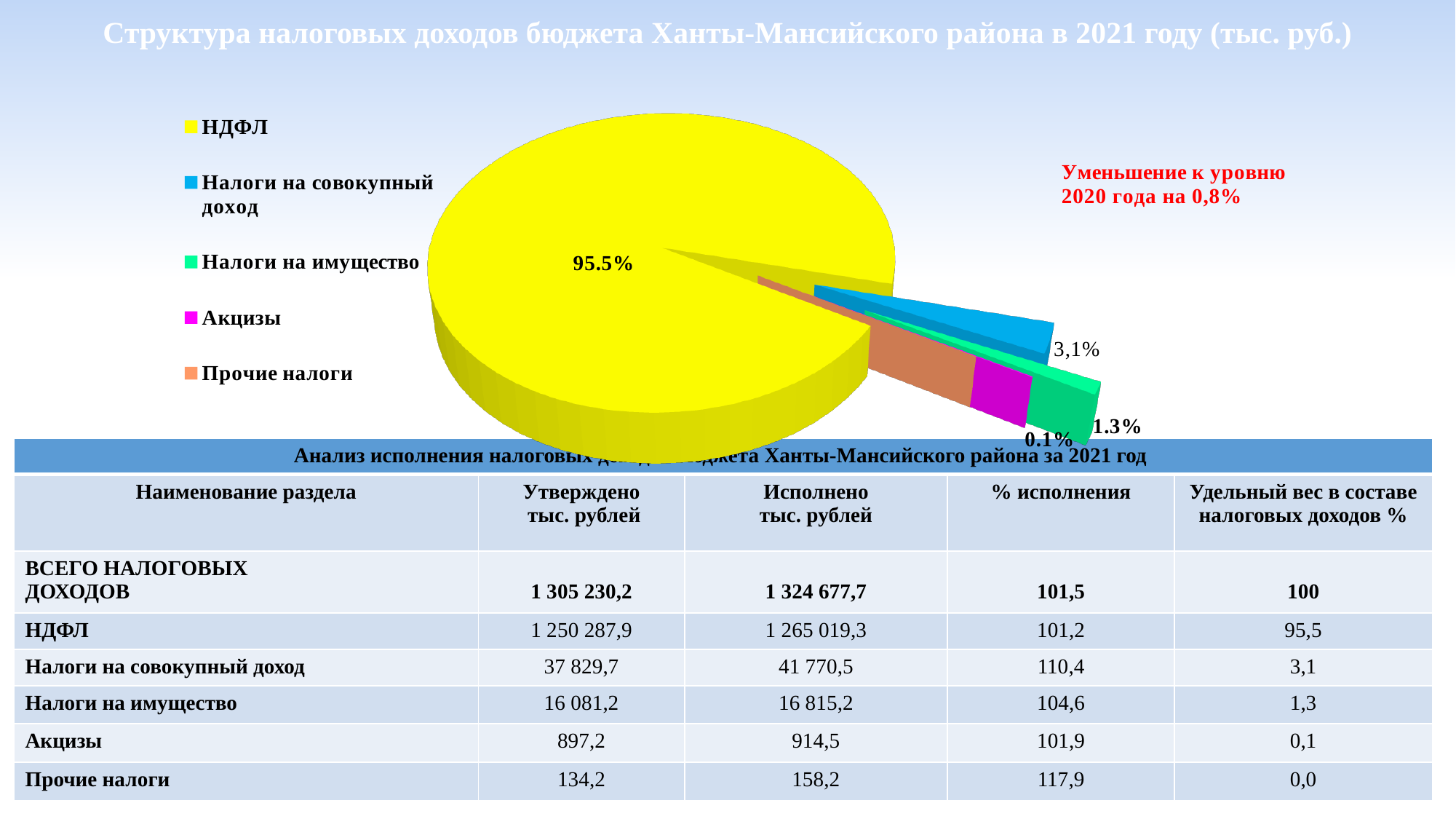
What share of the pie chart is labelled for Налоги на имущество? 1.3% What colour is the НДФЛ slice in the pie chart? yellow What share of the pie chart is labelled for Акцизы? 0.1% What colour is the Акцизы slice in the pie chart? magenta Which slice is larger in the pie chart: Налоги на имущество or Акцизы? Налоги на имущество Is the share for НДФЛ in the pie chart greater or less than 90%? greater Which slice is larger in the pie chart: Налоги на совокупный доход or Налоги на имущество? Налоги на совокупный доход What share of the pie chart does НДФЛ account for? 95.5% What type of chart is shown on the slide? pie chart How many categories does the pie chart legend list? 5 What share of the pie chart is labelled for Налоги на совокупный доход? 3,1% Which category has the largest slice in the pie chart? НДФЛ